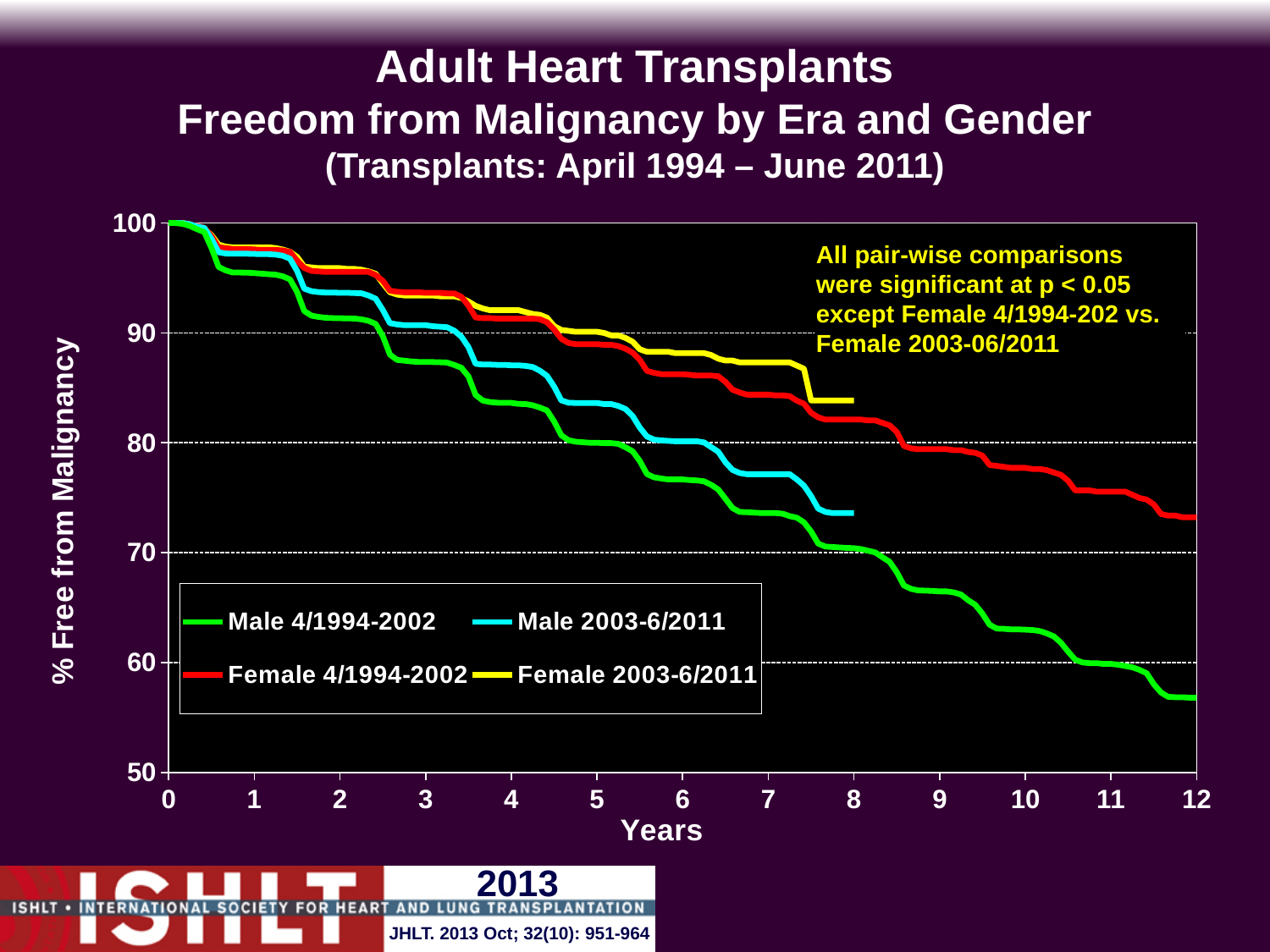
Which series has the lowest value at 12 years? Male 4/1994-2002 Do the values for Male 4/1994-2002 rise or fall as years increase? fall Is the value for Male 4/1994-2002 at 12 years greater or less than 60? less Is the value for Female 2003-6/2011 at 8 years greater or less than 80? greater Is the value for Male 2003-6/2011 at 8 years greater or less than 70? greater What kind of chart is shown on the slide? line chart At 12 years, which is higher: Female 4/1994-2002 or Male 4/1994-2002? Female 4/1994-2002 How many series does the legend list? 4 What is the label of the y axis? % Free from Malignancy At 8 years, which is higher: Female 2003-6/2011 or Male 2003-6/2011? Female 2003-6/2011